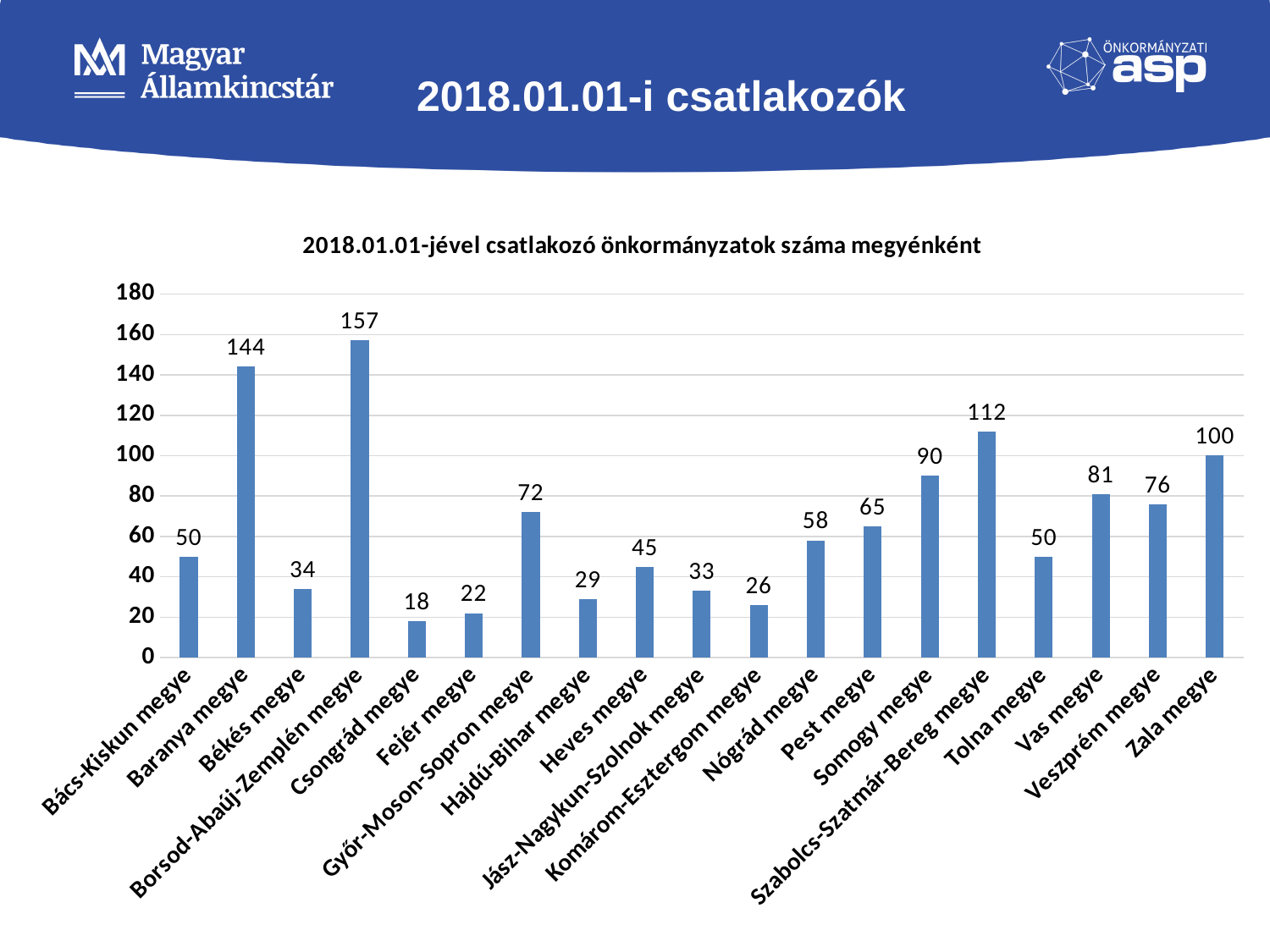
What is the difference between the values for Pest megye and Nógrád megye? 7 How many counties are shown on the x axis? 19 What kind of chart is shown on the slide? bar chart Which is larger, the value for Somogy megye or the value for Vas megye? Somogy megye What is the difference between the values for Borsod-Abaúj-Zemplén megye and Baranya megye? 13 What is the value for Csongrád megye? 18 What is the value for Baranya megye? 144 Which county has the lowest value? Csongrád megye What is the title of the chart? 2018.01.01-jével csatlakozó önkormányzatok száma megyénként Which county has the highest value? Borsod-Abaúj-Zemplén megye Is the value for Zala megye greater or less than 80? greater What is the value for Szabolcs-Szatmár-Bereg megye? 112